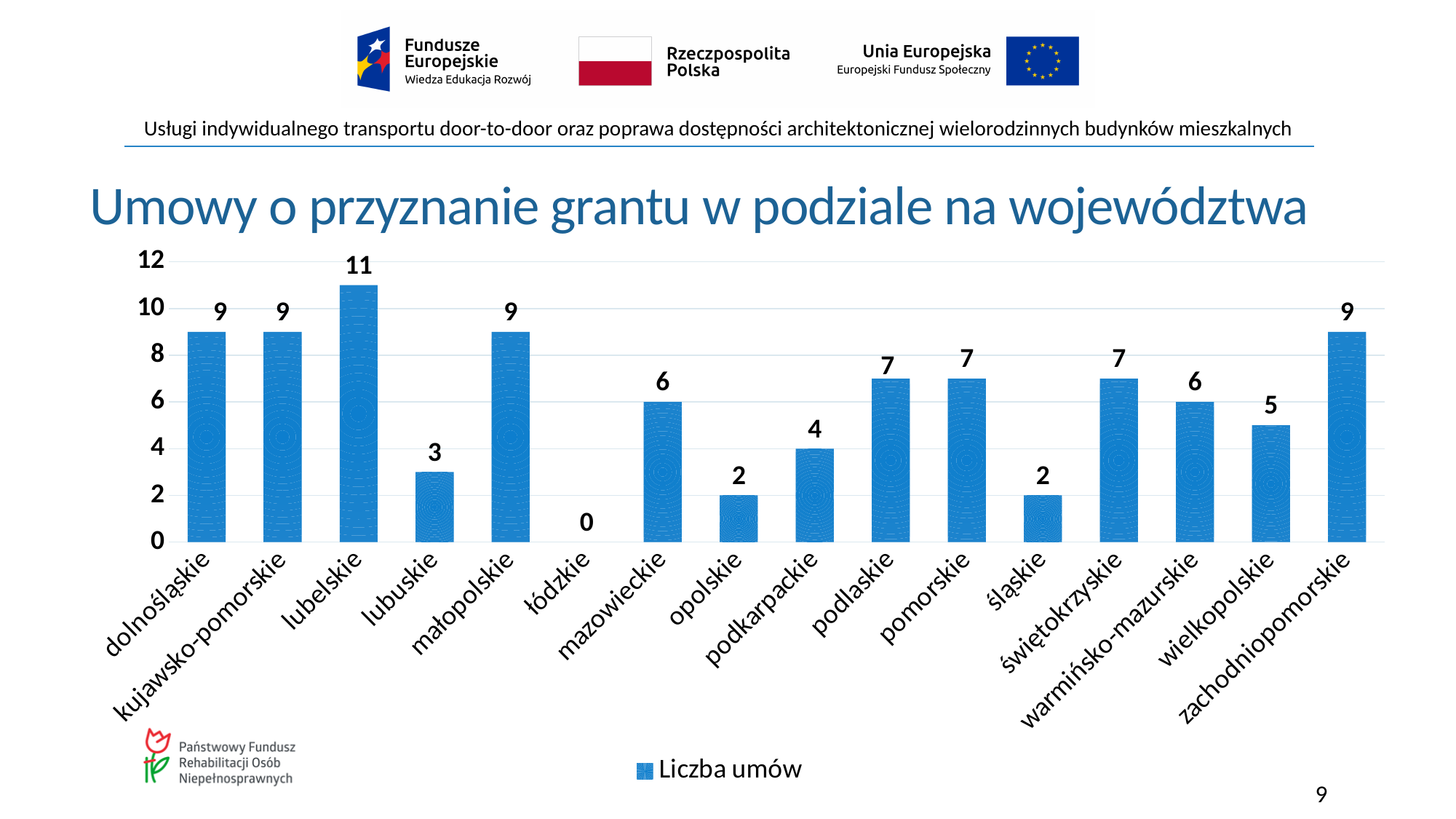
What is the value for łódzkie? 0 How many series does the legend list? 1 What is the title of the chart? Umowy o przyznanie grantu w podziale na województwa Which is larger, the value for mazowieckie or the value for wielkopolskie? mazowieckie What is the value for podkarpackie? 4 What kind of chart is shown on the slide? bar chart What is the difference between the values for lubelskie and lubuskie? 8 How many voivodeships are shown on the x axis? 16 What is the value for lubelskie? 11 Which voivodeship has the lowest number of agreements? łódzkie What is the legend entry for the series? Liczba umów Which voivodeship has the highest number of agreements? lubelskie